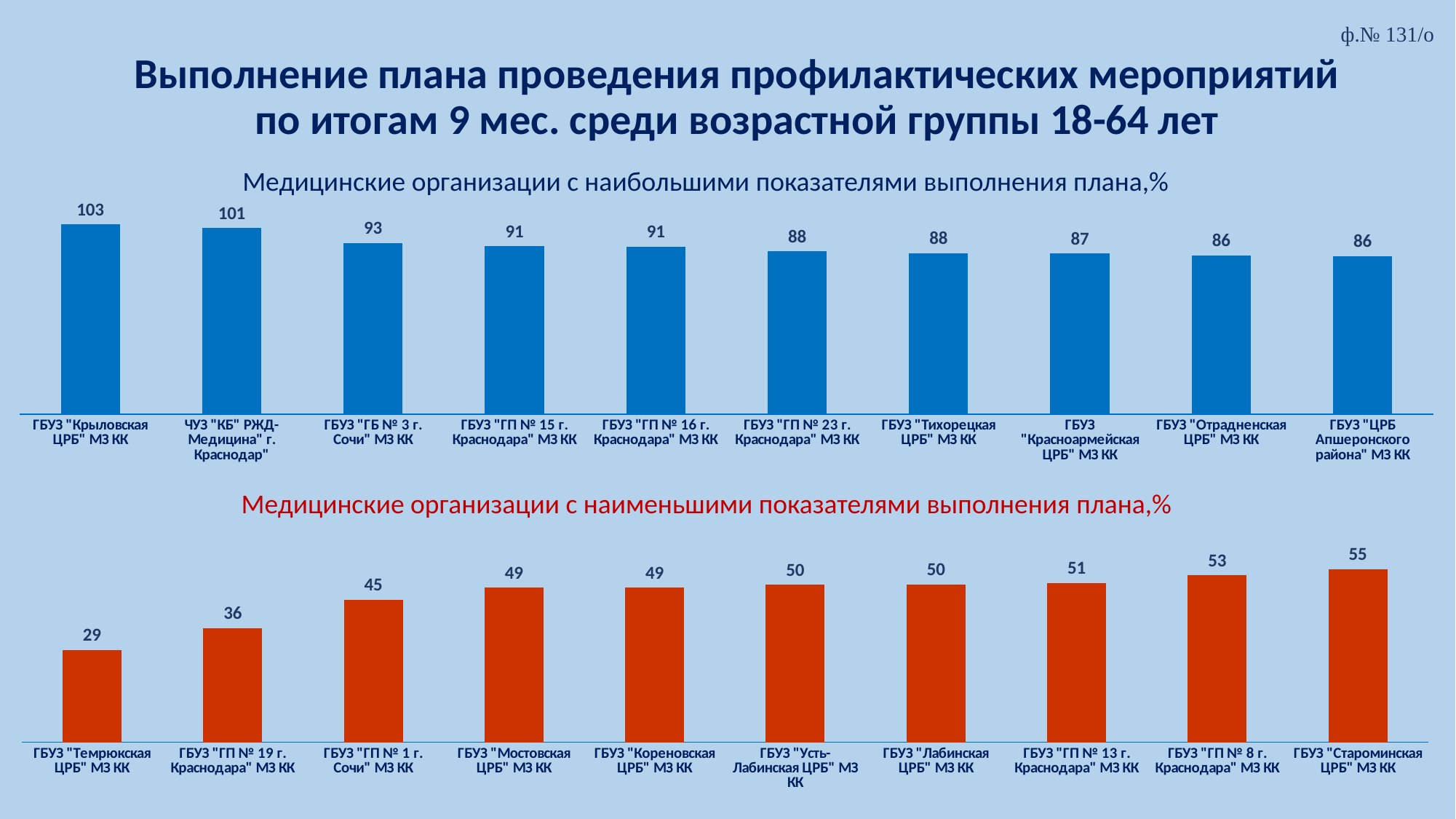
In the bottom chart, which is larger: the value for ГБУЗ "ГП № 1 г. Сочи" МЗ КК or the value for ГБУЗ "ГП № 8 г. Краснодара" МЗ КК? ГБУЗ "ГП № 8 г. Краснодара" МЗ КК In the bottom chart, which organisation has the lowest value? ГБУЗ "Темрюкская ЦРБ" МЗ КК In the bottom chart, do the values rise or fall from left to right? rise In the bottom chart (organisations with the lowest plan fulfilment), what is the value for ГБУЗ "Темрюкская ЦРБ" МЗ КК? 29 In the top chart, what is the value for ГБУЗ "ГБ № 3 г. Сочи" МЗ КК? 93 In the bottom chart, what is the value for ГБУЗ "Староминская ЦРБ" МЗ КК? 55 In the top chart, what is the difference between the values for ГБУЗ "Крыловская ЦРБ" МЗ КК and ЧУЗ "КБ" РЖД-Медицина" г. Краснодар"? 2 In the top chart, which organisation has the highest value? ГБУЗ "Крыловская ЦРБ" МЗ КК How many organisations are shown in the top chart? 10 What type of chart is the bottom chart? bar chart In the bottom chart, what is the difference between the values for ГБУЗ "ГП № 19 г. Краснодара" МЗ КК and ГБУЗ "Темрюкская ЦРБ" МЗ КК? 7 In the top chart (organisations with the highest plan fulfilment), what is the value for ГБУЗ "Крыловская ЦРБ" МЗ КК? 103